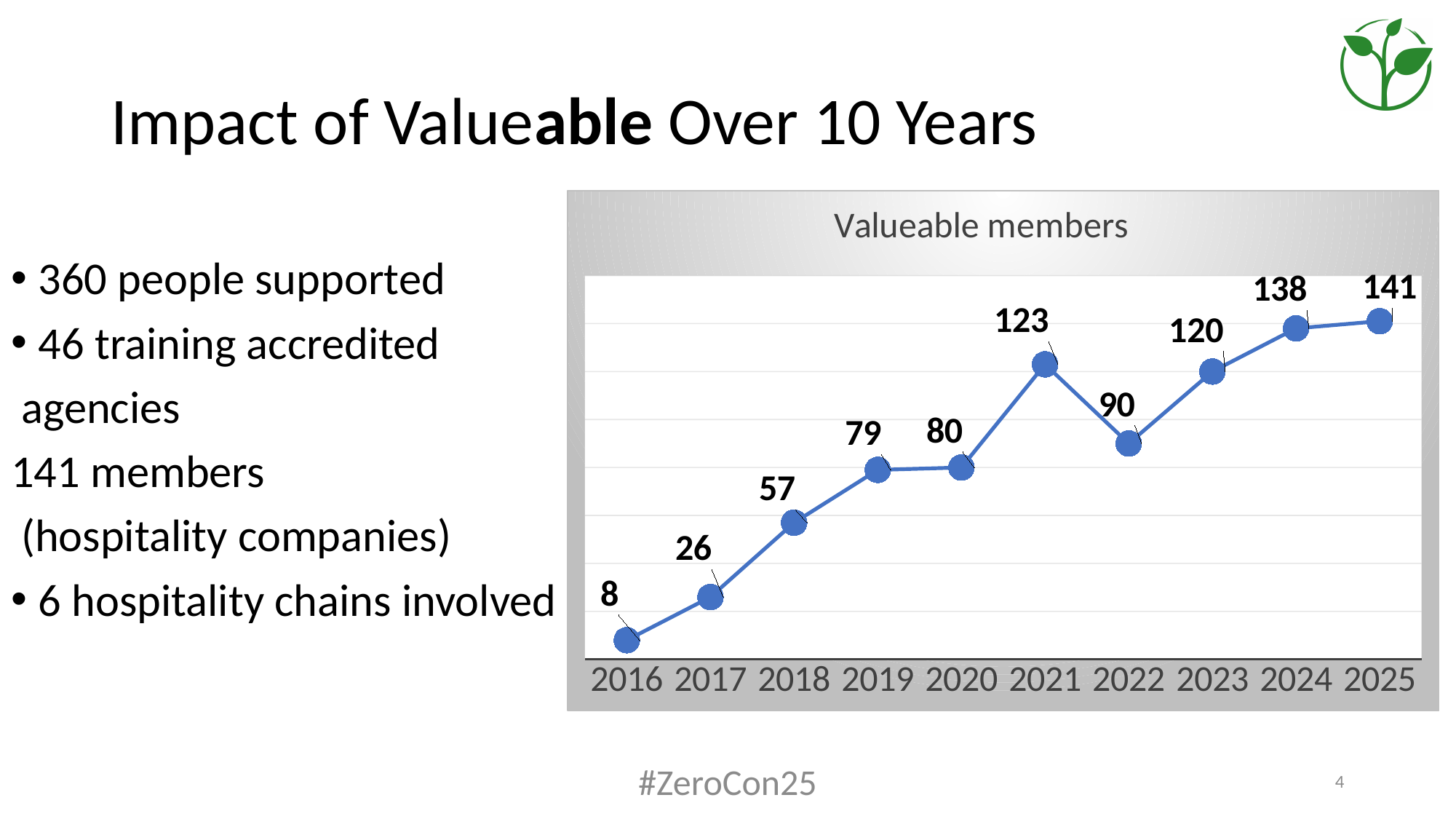
What is the value for 2021 in the Valueable members chart? 123 Which year has the highest value in the Valueable members chart? 2025 How many years are plotted in the Valueable members chart? 10 What is the value for 2016 in the Valueable members chart? 8 What kind of chart is the Valueable members chart? line chart What is the difference between the values for 2025 and 2016 in the Valueable members chart? 133 Do the values in the Valueable members chart rise or fall from 2016 to 2021? rise What is the title of the chart on the slide? Valueable members Which year has the lowest value in the Valueable members chart? 2016 What is the difference between the values for 2021 and 2022 in the Valueable members chart? 33 What is the value for 2022 in the Valueable members chart? 90 Which is larger in the Valueable members chart, the value for 2021 or the value for 2023? 2021